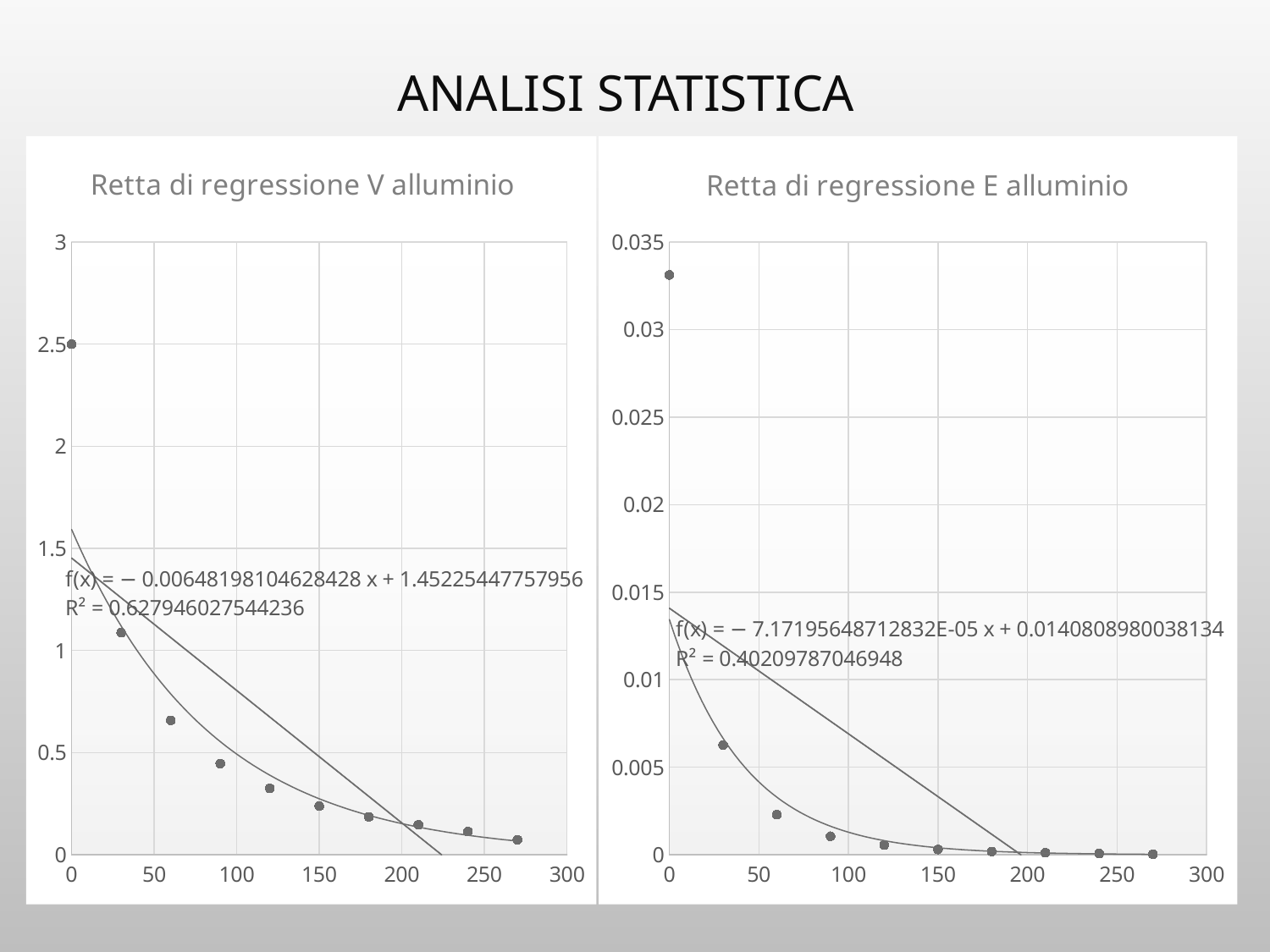
What R² value is shown on the 'Retta di regressione V alluminio' chart? 0.627946027544236 How many data points are plotted in the 'Retta di regressione V alluminio' chart? 10 How many data points are plotted in the 'Retta di regressione E alluminio' chart? 10 In the 'Retta di regressione V alluminio' chart, is the value of the point at x = 60 greater or less than 1? less In the 'Retta di regressione V alluminio' chart, which point has the larger value, the one at x = 30 or the one at x = 60? x = 30 What R² value is shown on the 'Retta di regressione E alluminio' chart? 0.40209787046948 What kind of chart is the 'Retta di regressione E alluminio' chart? scatter chart In the 'Retta di regressione V alluminio' chart, at which x value is the plotted point highest? 0 In the 'Retta di regressione V alluminio' chart, what is the y value of the point at x = 0? 2.5 In the 'Retta di regressione E alluminio' chart, is the value of the point at x = 0 greater or less than 0.03? greater In the 'Retta di regressione V alluminio' chart, do the plotted values rise or fall as x increases? fall What kind of chart is the 'Retta di regressione V alluminio' chart? scatter chart